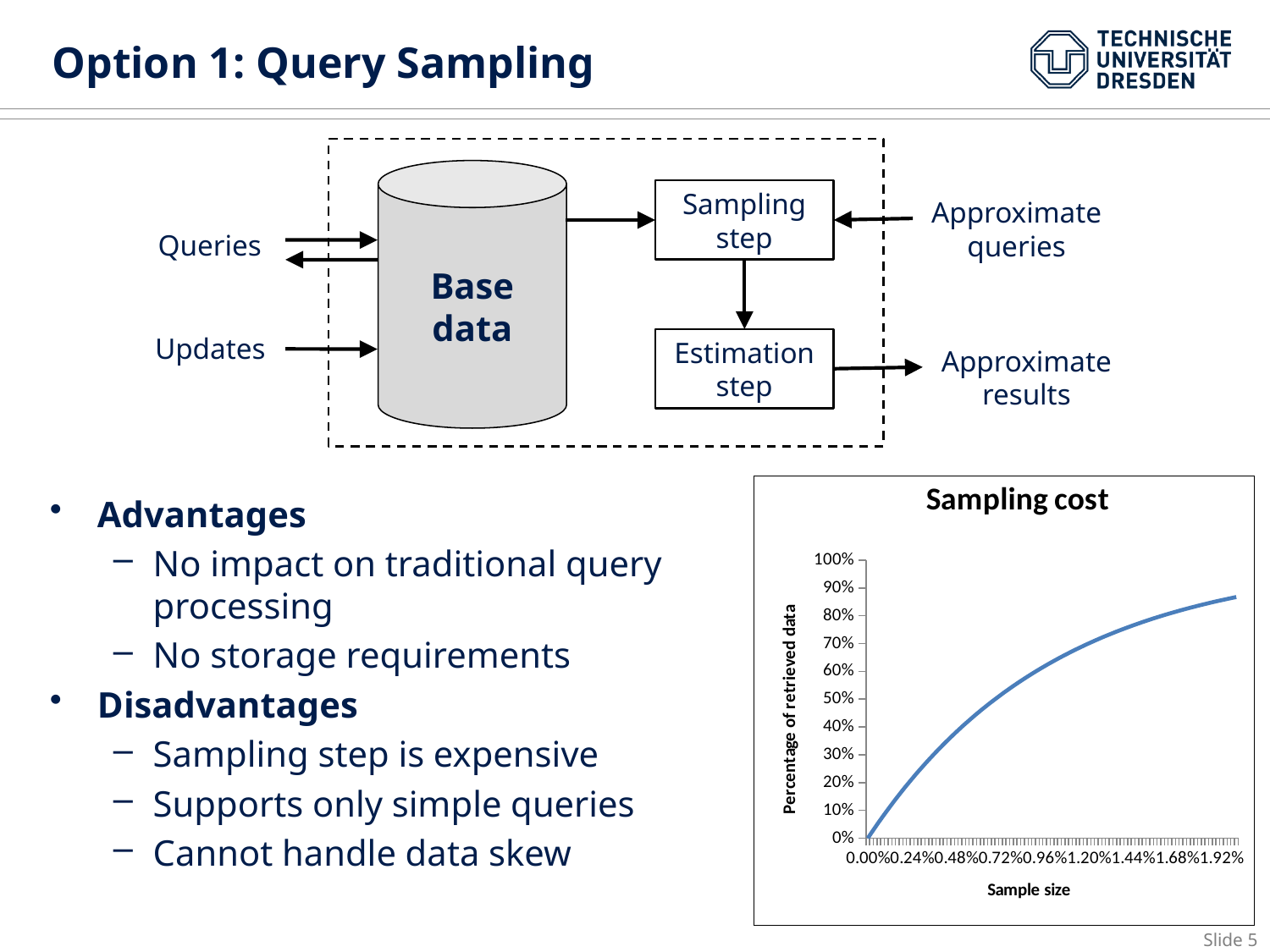
In the 'Sampling cost' chart, is the percentage of retrieved data at a sample size of 1.92% greater or less than 80%? greater In the 'Sampling cost' chart, what is the percentage of retrieved data at a sample size of 0.00%? 0% What is the title of the chart on the slide? Sampling cost What is the largest sample size value labelled on the x axis of the 'Sampling cost' chart? 1.92% What is the label of the y axis in the 'Sampling cost' chart? Percentage of retrieved data In the 'Sampling cost' chart, is the percentage of retrieved data at a sample size of 0.24% greater or less than 30%? less In the 'Sampling cost' chart, is the percentage of retrieved data at a sample size of 0.48% greater or less than 50%? less In the 'Sampling cost' chart, which sample size has the higher percentage of retrieved data, 0.48% or 1.44%? 1.44% What kind of chart is the 'Sampling cost' chart? line chart In the 'Sampling cost' chart, does the percentage of retrieved data rise or fall as the sample size increases? rise